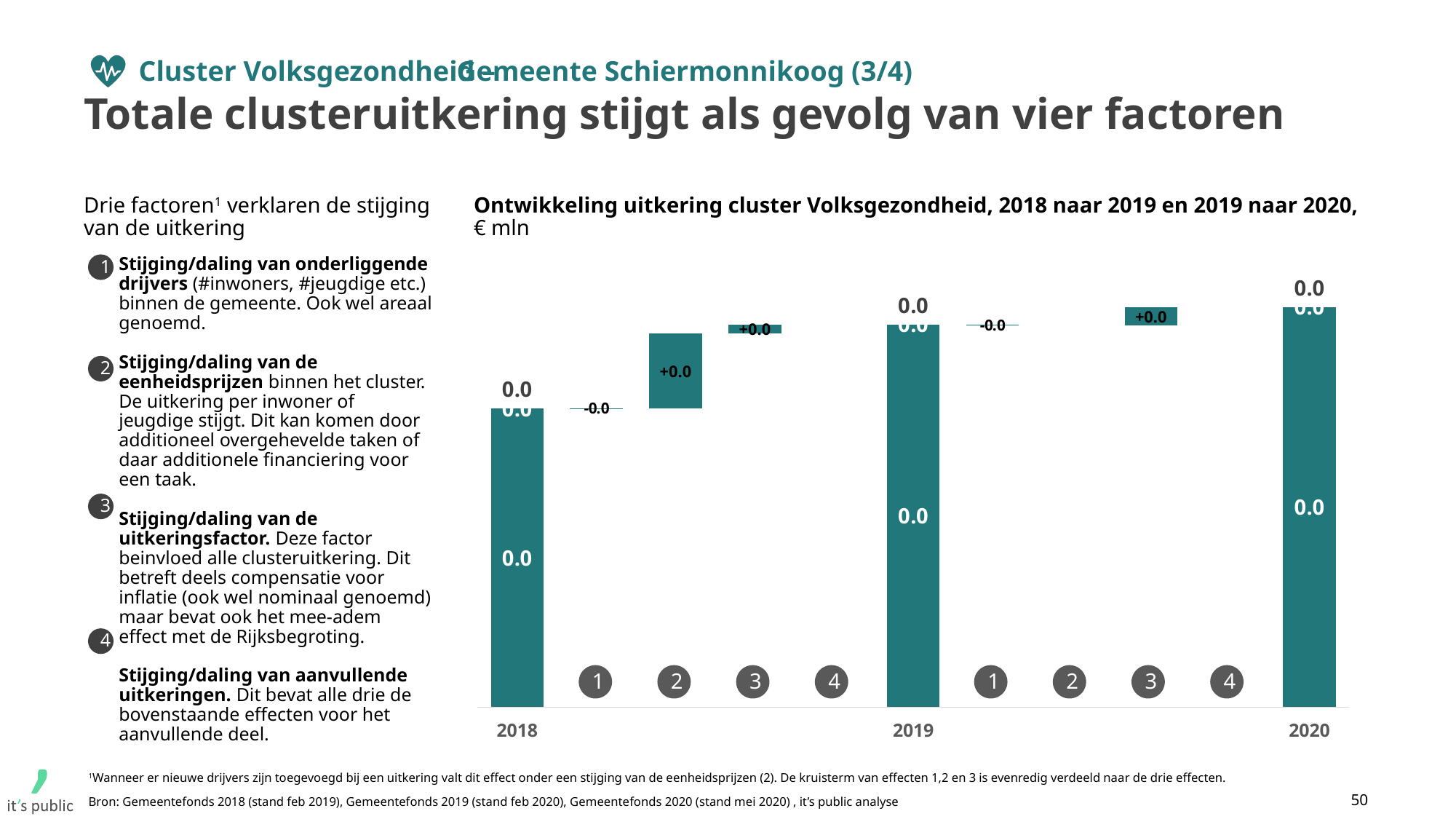
How many years are labelled on the x axis of the chart? 3 What is the data label printed above the 2020 bar? 0.0 In what unit are the chart values expressed, according to the chart title? € mln How many numbered factor steps are shown between the 2018 and 2019 bars? 4 What is the data label on the factor 2 step between 2018 and 2019? +0.0 What is the data label on the factor 1 step between 2018 and 2019? -0.0 What is the data label on the factor 3 step between 2018 and 2019? +0.0 What is the data label printed above the 2018 bar? 0.0 What is the data label printed above the 2019 bar? 0.0 What is the data label on the factor 3 step between 2019 and 2020? +0.0 What is the data label on the factor 1 step between 2019 and 2020? -0.0 What kind of chart is shown on the slide? bar chart